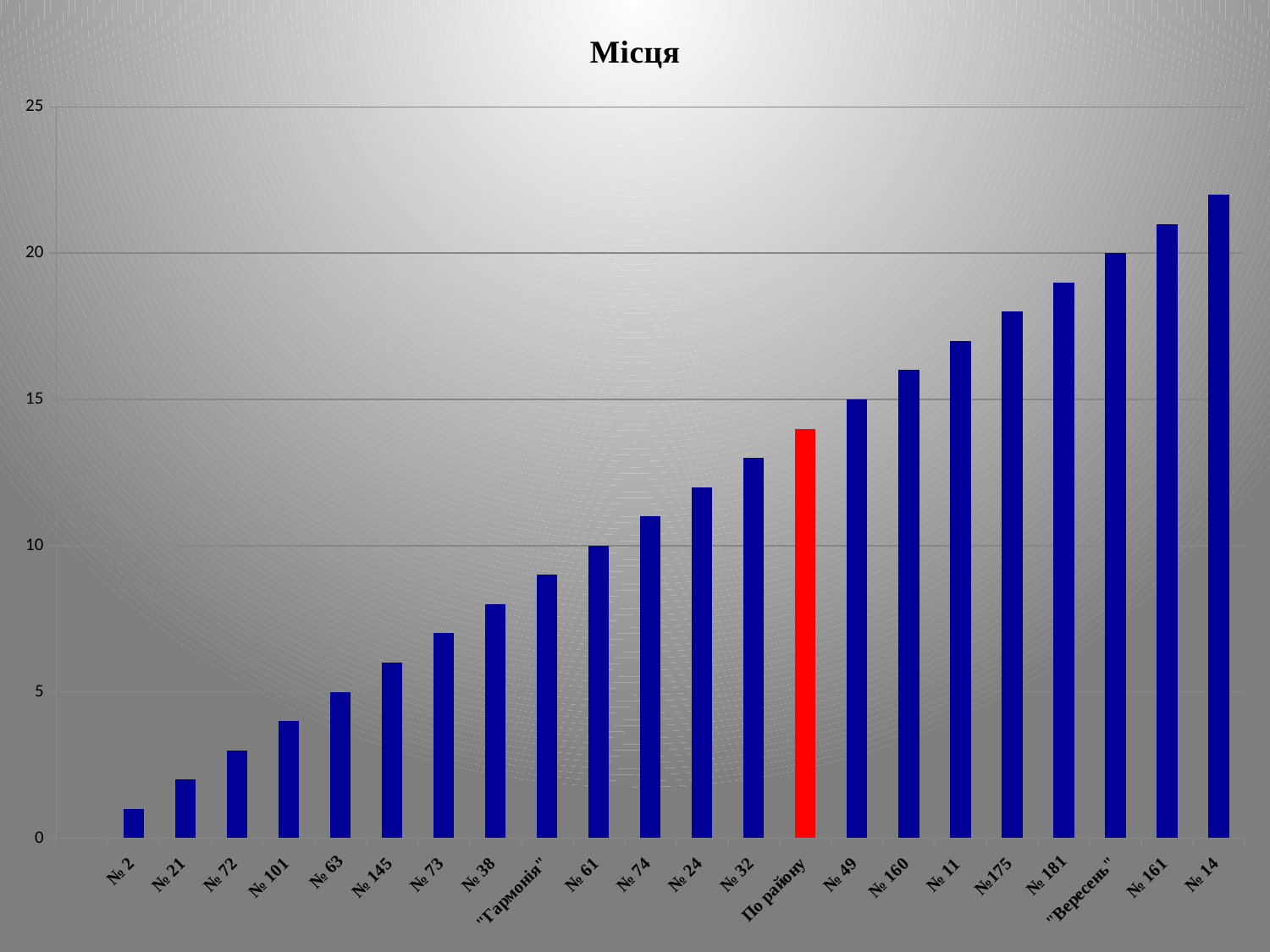
Is the value for По району greater or less than 15? less Is the value for № 161 greater or less than 20? greater What kind of chart is shown on the slide? bar chart Which category is shown with a red bar? По району What is the value for № 61? 10 What is the value for № 49? 15 Which category has the highest value? № 14 What is the value for № 63? 5 How many categories are plotted on the x axis? 22 What is the value for "Вересень"? 20 What is the title of the chart? Місця Which category has the lowest value? № 2